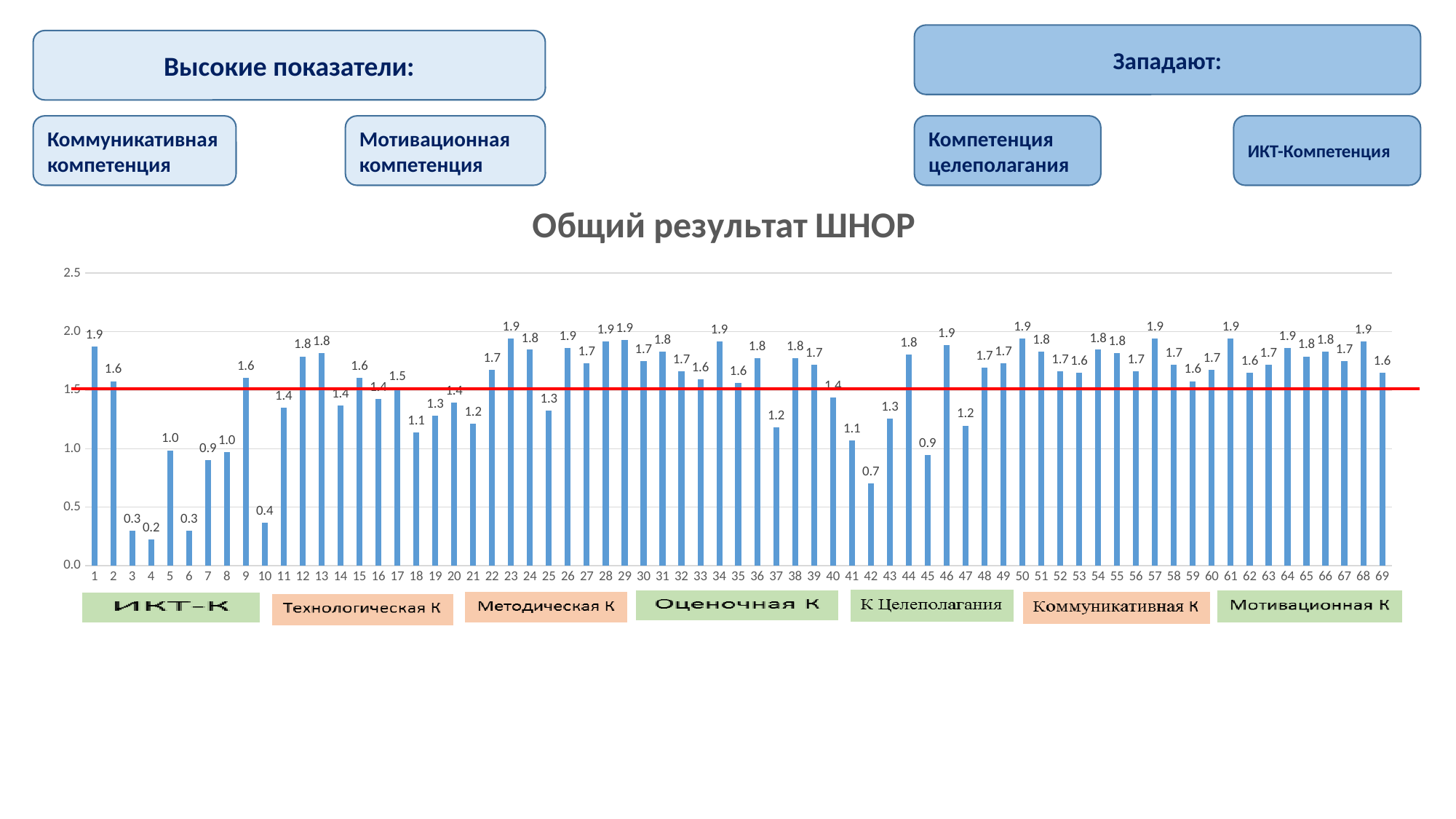
Is the value for category 10 greater or less than 0.5? less At what value on the y axis is the horizontal red line drawn? 1.5 What is the value for category 42? 0.7 What is the value for category 4? 0.2 What is the difference between the values for category 1 and category 4? 1.7 How many categories are plotted along the x axis of the chart? 69 What is the title of the chart? Общий результат ШНОР What is the value for category 17? 1.5 Which has the larger value, category 45 or category 46? 46 What is the difference between the values for category 43 and category 42? 0.6 Which category has the lowest value? 4 What kind of chart is shown on the slide? bar chart